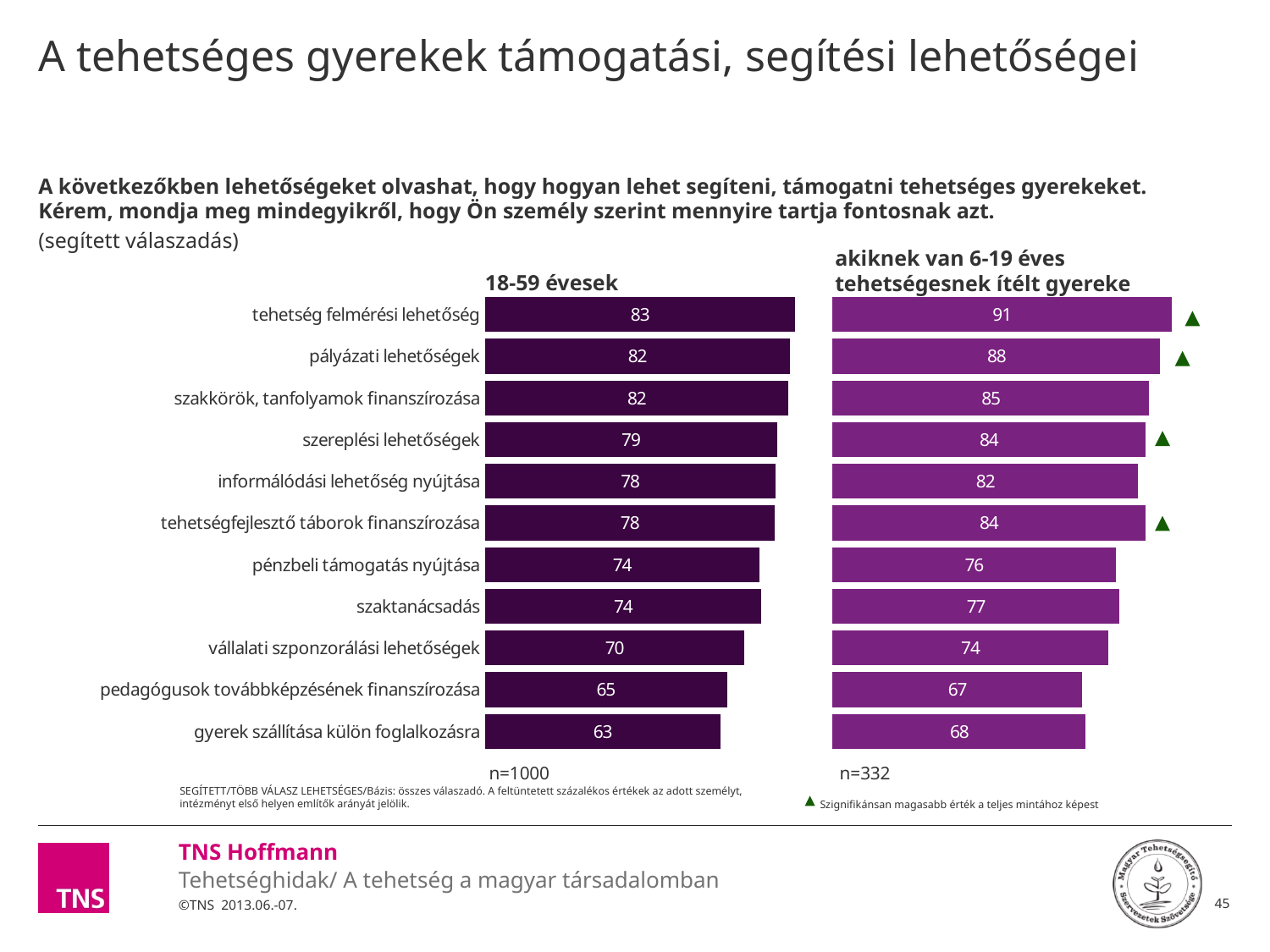
How many categories are shown in the "18-59 évesek" chart? 11 In the "akiknek van 6-19 éves tehetségesnek ítélt gyereke" chart, what is the value for "pályázati lehetőségek"? 88 In the "18-59 évesek" chart, what is the difference between "szereplési lehetőségek" and "vállalati szponzorálási lehetőségek"? 9 In the "18-59 évesek" chart, what is the value for "tehetség felmérési lehetőség"? 83 What is the sample size (n) shown under the "akiknek van 6-19 éves tehetségesnek ítélt gyereke" chart? n=332 In the "18-59 évesek" chart, what is the value for "pedagógusok továbbképzésének finanszírozása"? 65 Which is larger: the value for "szaktanácsadás" in the "18-59 évesek" chart or in the "akiknek van 6-19 éves tehetségesnek ítélt gyereke" chart? akiknek van 6-19 éves tehetségesnek ítélt gyereke In the "akiknek van 6-19 éves tehetségesnek ítélt gyereke" chart, which category has the highest value? tehetség felmérési lehetőség In the "akiknek van 6-19 éves tehetségesnek ítélt gyereke" chart, which category has the lowest value? pedagógusok továbbképzésének finanszírozása In the "18-59 évesek" chart, which category has the lowest value? gyerek szállítása külön foglalkozásra What type of chart is the "18-59 évesek" chart? bar chart What is the difference between the value for "tehetség felmérési lehetőség" in the "akiknek van 6-19 éves tehetségesnek ítélt gyereke" chart and in the "18-59 évesek" chart? 8